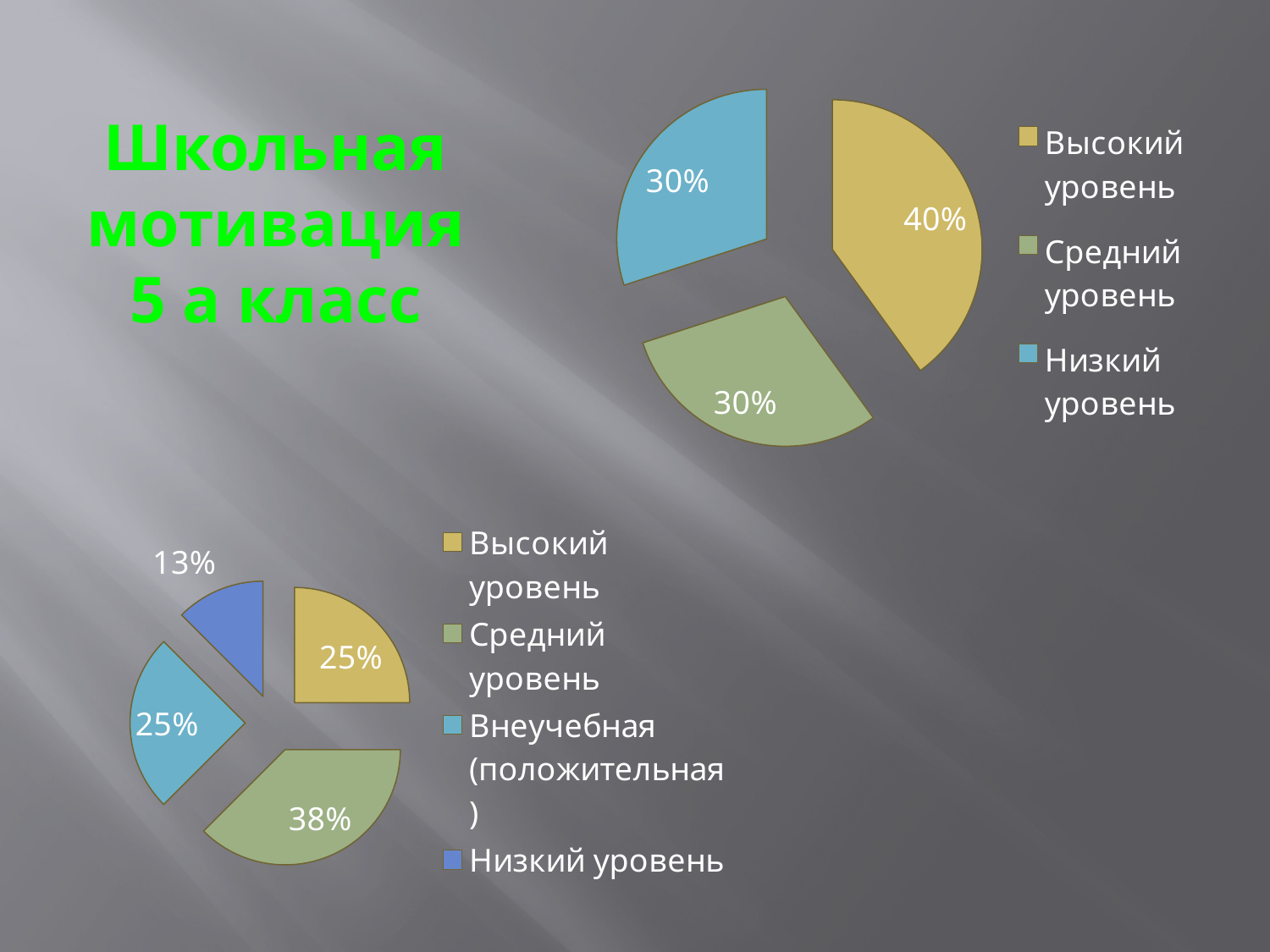
What type of chart is the top-right chart? Pie chart In the bottom-left pie chart, what share is labelled for Средний уровень? 38% In the top-right pie chart, which category has the largest slice? Высокий уровень How many slices does the top-right pie chart have? 3 In the top-right pie chart, what share is labelled for Низкий уровень? 30% In the top-right pie chart, what share is labelled for Высокий уровень? 40% In the bottom-left pie chart, which is larger: Средний уровень or Низкий уровень? Средний уровень In the bottom-left pie chart, which category has the largest slice? Средний уровень In the top-right pie chart, what is the difference between the Высокий уровень and Средний уровень shares? 10% In the bottom-left pie chart, what share is labelled for Низкий уровень? 13% How many categories does the legend of the bottom-left pie chart list? 4 In the bottom-left pie chart, which category has the smallest slice? Низкий уровень